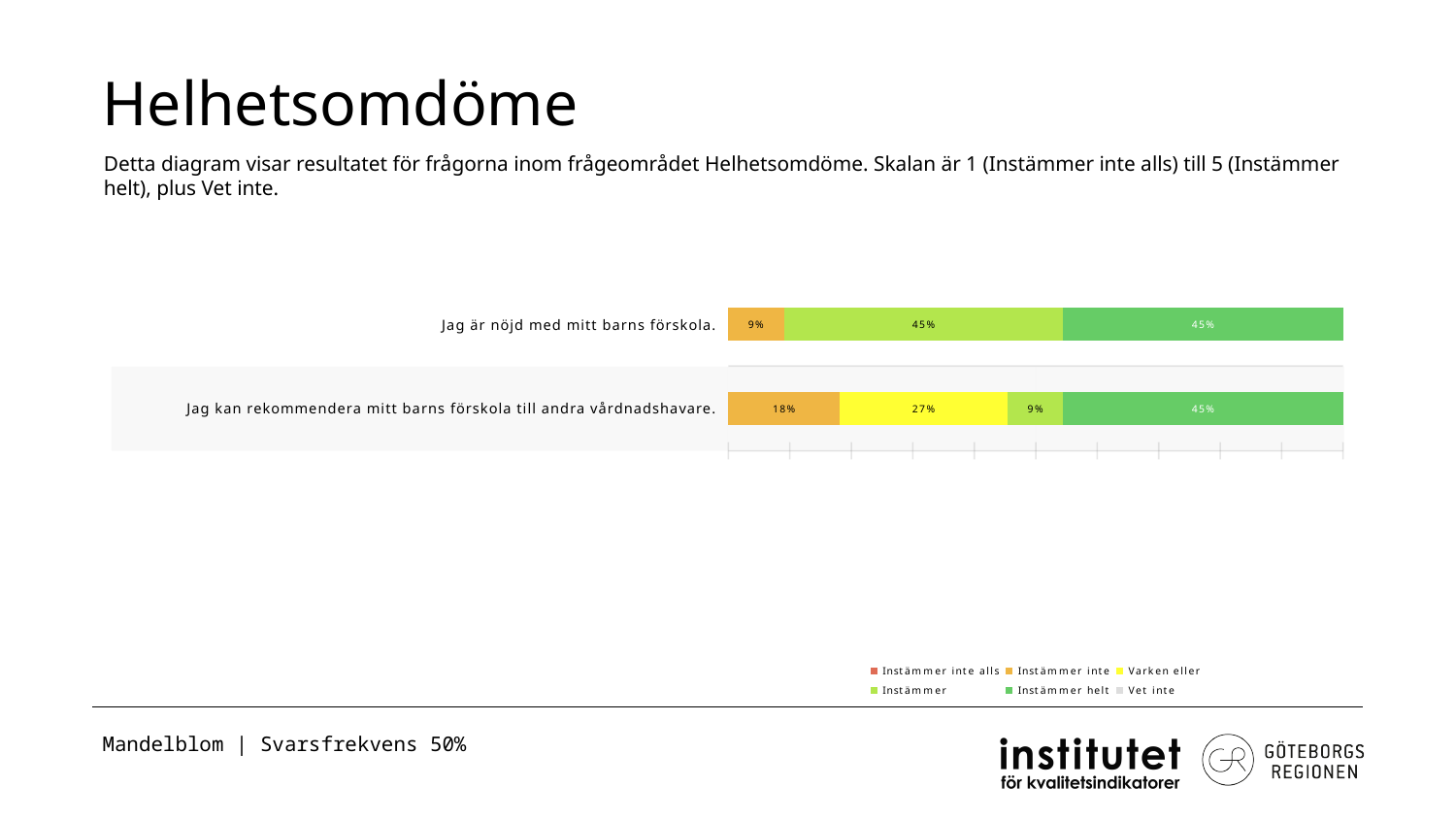
What is the 'Instämmer inte' value for 'Jag är nöjd med mitt barns förskola.'? 9% What is the 'Varken eller' value for 'Jag kan rekommendera mitt barns förskola till andra vårdnadshavare.'? 27% What kind of chart is shown on the slide? stacked bar chart What is the 'Instämmer helt' value for 'Jag är nöjd med mitt barns förskola.'? 45% What is the 'Instämmer' value for 'Jag kan rekommendera mitt barns förskola till andra vårdnadshavare.'? 9% How many series does the legend list? 6 What is the difference between the 'Instämmer' values for 'Jag är nöjd med mitt barns förskola.' and 'Jag kan rekommendera mitt barns förskola till andra vårdnadshavare.'? 36% Which legend entry is shown in grey? Vet inte Which statement has the larger 'Instämmer inte' value? Jag kan rekommendera mitt barns förskola till andra vårdnadshavare. How many categories (statements) are plotted in the chart? 2 What is the 'Instämmer inte' value for 'Jag kan rekommendera mitt barns förskola till andra vårdnadshavare.'? 18% What is the total of the labelled segments in the bar for 'Jag är nöjd med mitt barns förskola.'? 99%